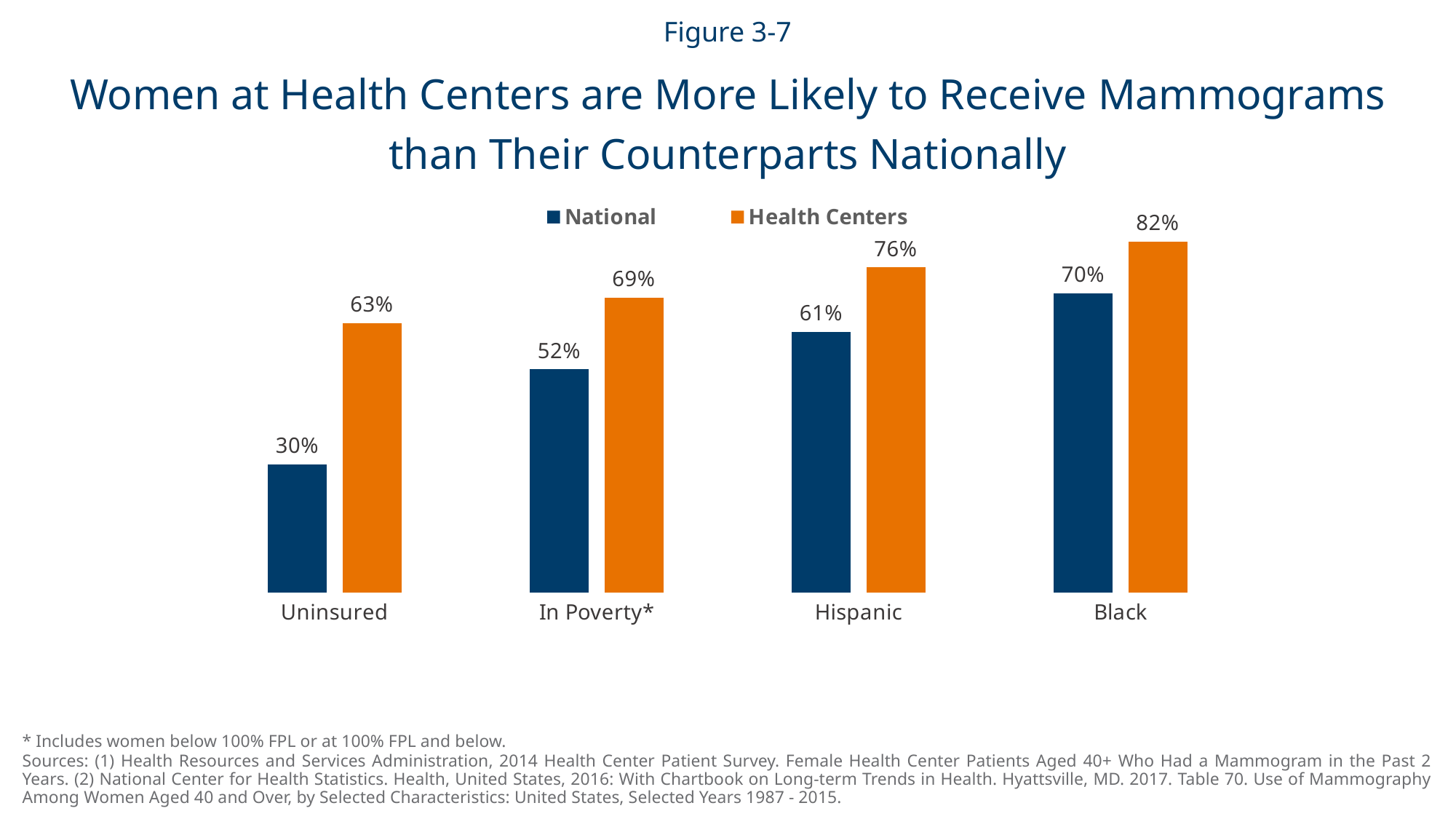
Which category has the lowest National value? Uninsured What is the Health Centers value for women In Poverty*? 69% Which category has the highest Health Centers value? Black What is the difference between the Health Centers and National values for Black women? 12% What is the Health Centers value for Hispanic women? 76% Which colour represents the Health Centers series? Orange What is the National value for Uninsured women? 30% Which is larger, the National value for Hispanic women or the National value for women In Poverty*? Hispanic How many series does the legend list? 2 What kind of chart is shown on the slide? Bar chart How many categories are shown on the x axis? 4 What is the difference between the Health Centers and National values for Uninsured women? 33%